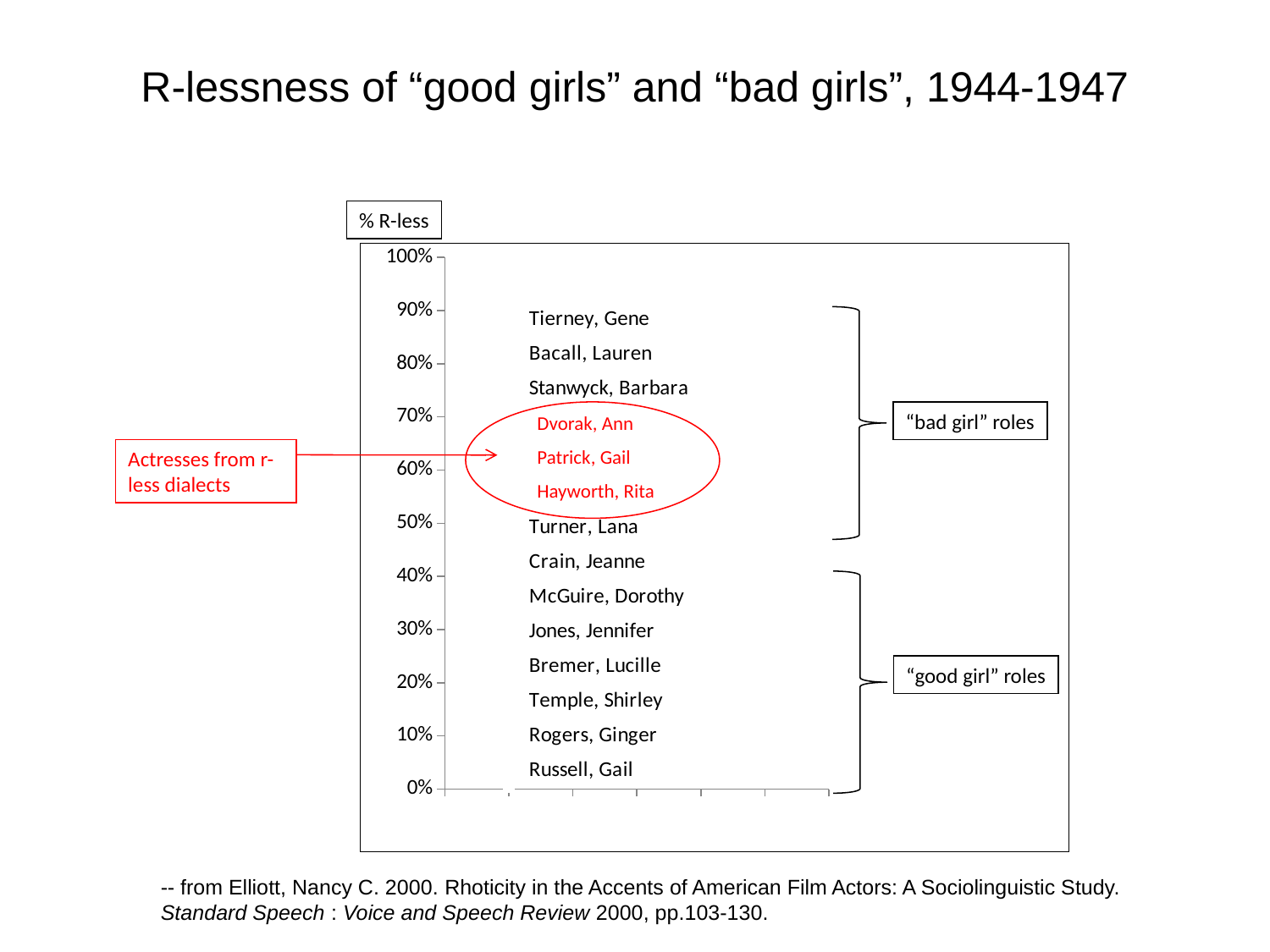
How many actresses are grouped under "good girl" roles? 7 How many actresses are grouped under "bad girl" roles? 7 What is the label on the vertical axis of the chart? % R-less How many actresses are listed on the chart? 14 Which actress is listed at the bottom of the chart? Russell, Gail Is Turner, Lana grouped under "bad girl" roles or "good girl" roles? "bad girl" roles Which actress is listed at the top of the chart? Tierney, Gene What is the title of the slide's chart? R-lessness of "good girls" and "bad girls", 1944-1947